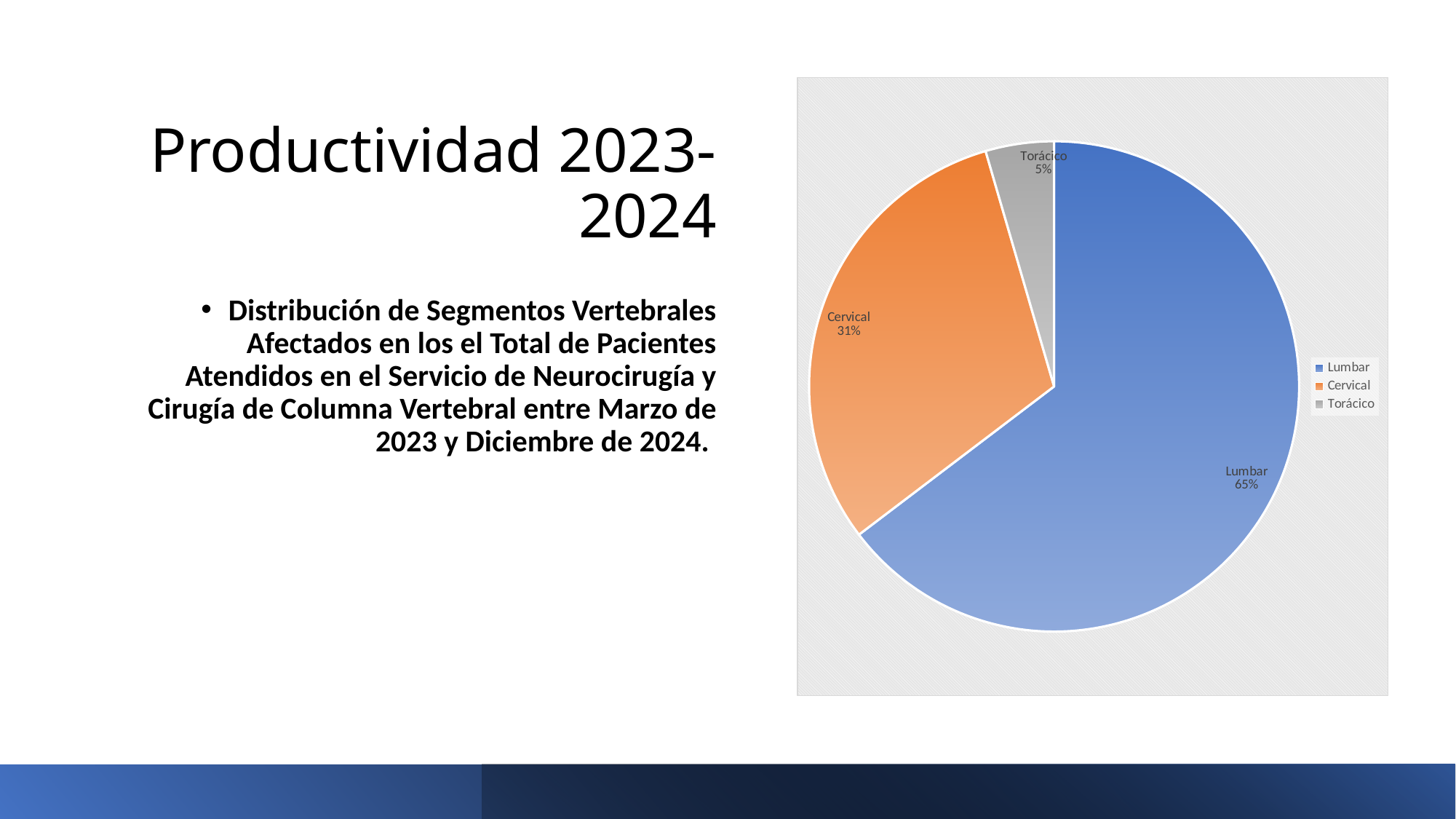
Which is larger, the Cervical share or the Torácico share? Cervical What share of the pie does the Cervical slice represent? 31% Which segment has the largest share of the pie? Lumbar What is the difference in percentage points between the Lumbar and Cervical shares? 34 Which legend entry is shown in grey? Torácico What share of the pie does the Torácico slice represent? 5% What share of the pie does the Lumbar slice represent? 65% Which segment has the smallest share of the pie? Torácico How many slices does the pie chart have? 3 What kind of chart is shown on the slide? pie chart How many entries does the legend list? 3 What colour is the Cervical slice in the pie chart? orange